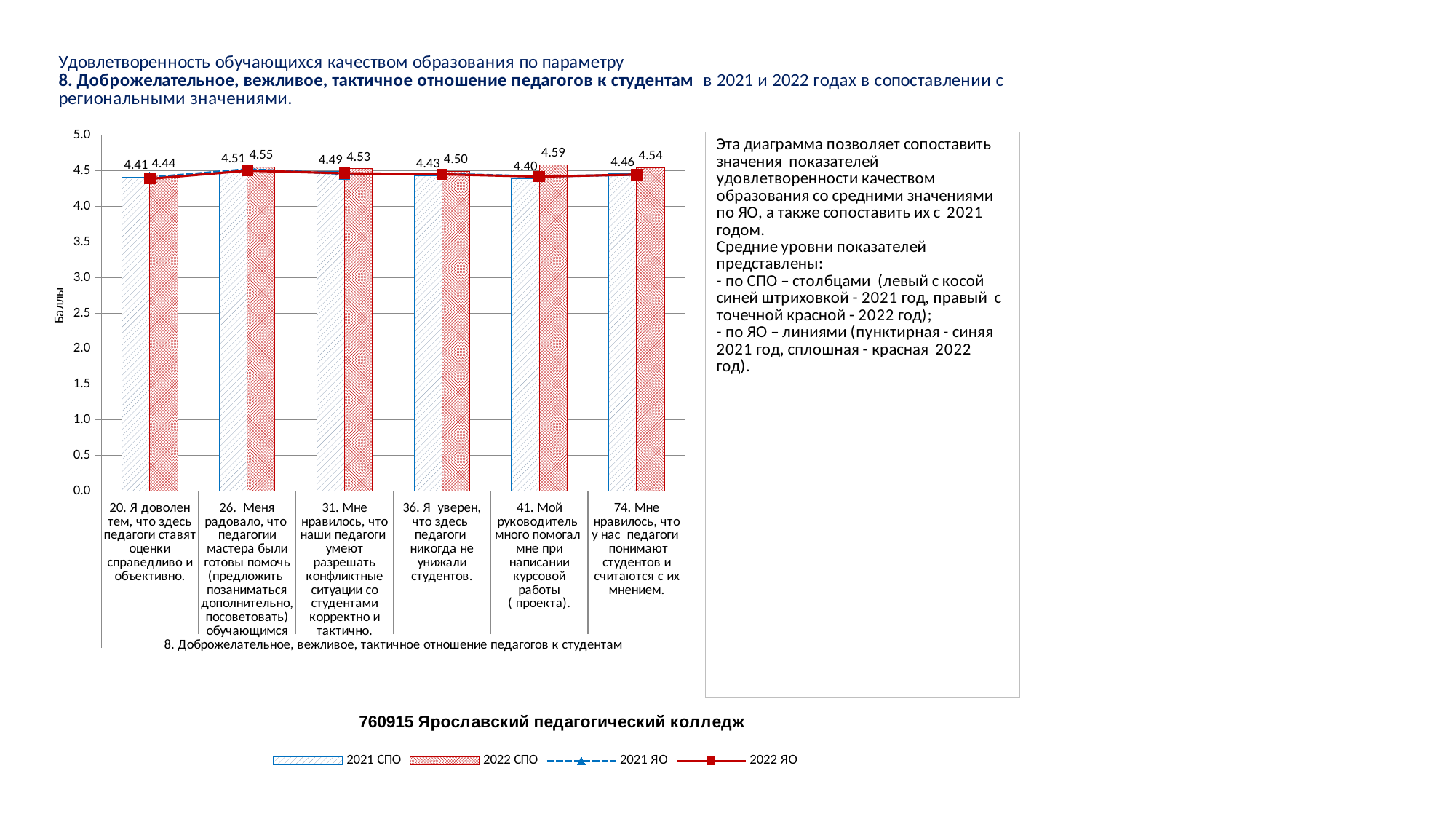
Which is larger for item 36: the 2021 СПО value or the 2022 СПО value? 2022 СПО (4.50) How many series does the chart legend list? 4 What is the 2022 СПО value for item 41 (Мой руководитель много помогал мне при написании курсовой работы)? 4.59 What is the difference between the 2022 СПО and 2021 СПО values for item 41? 0.19 Is the 2021 СПО value for item 31 greater or less than 4.0? greater What type of chart is used to show the СПО values? bar chart Which item has the lowest 2021 СПО value? 41. Мой руководитель много помогал мне при написании курсовой работы (проекта). Which item has the highest 2021 СПО value? 26. Меня радовало, что педагоги мастера были готовы помочь How many items (categories) are shown on the x axis of the chart? 6 Which item has the highest 2022 СПО value? 41. Мой руководитель много помогал мне при написании курсовой работы (проекта). What is the 2021 СПО value for item 20 (Я доволен тем, что здесь педагоги ставят оценки справедливо и объективно)? 4.41 What is the 2022 СПО value for item 74 (Мне нравилось, что у нас педагоги понимают студентов и считаются с их мнением)? 4.54